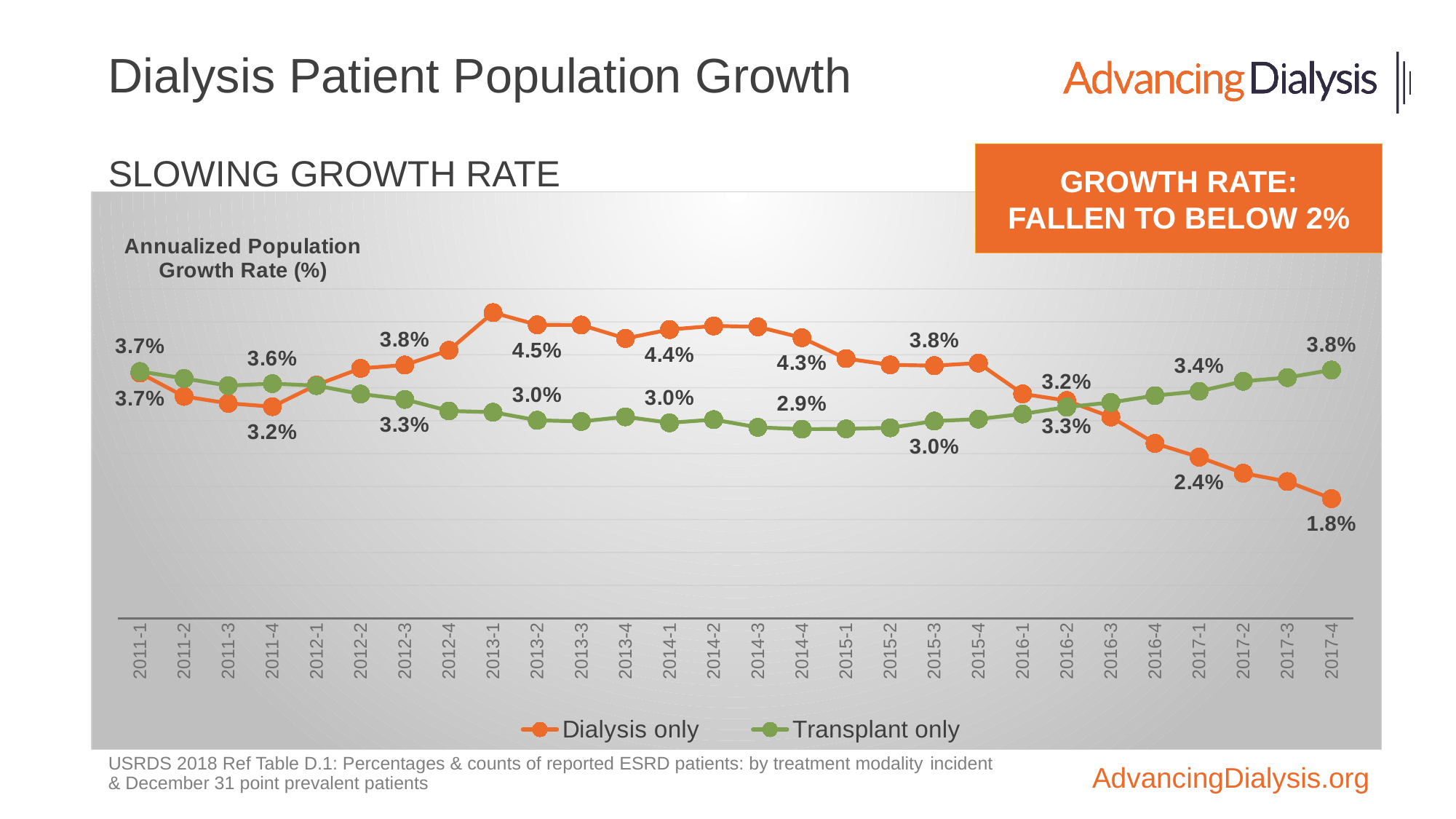
What is the Dialysis only growth rate at 2017-4? 1.8% What is the Transplant only growth rate at 2017-4? 3.8% At 2017-4, how much higher is the Transplant only rate than the Dialysis only rate? 2.0% What is the Transplant only growth rate at 2014-4? 2.9% At 2017-1, which series has the higher growth rate, Dialysis only or Transplant only? Transplant only At 2013-2, which series has the higher growth rate, Dialysis only or Transplant only? Dialysis only How many series does the chart legend list? 2 What kind of chart is shown on the slide? line chart By how much did the Dialysis only growth rate fall from 2011-1 to 2017-4? 1.9% In which quarter is the Dialysis only growth rate lowest? 2017-4 Does the Dialysis only growth rate rise or fall from 2015-4 to 2017-4? fall What is the Dialysis only growth rate at 2013-2? 4.5%